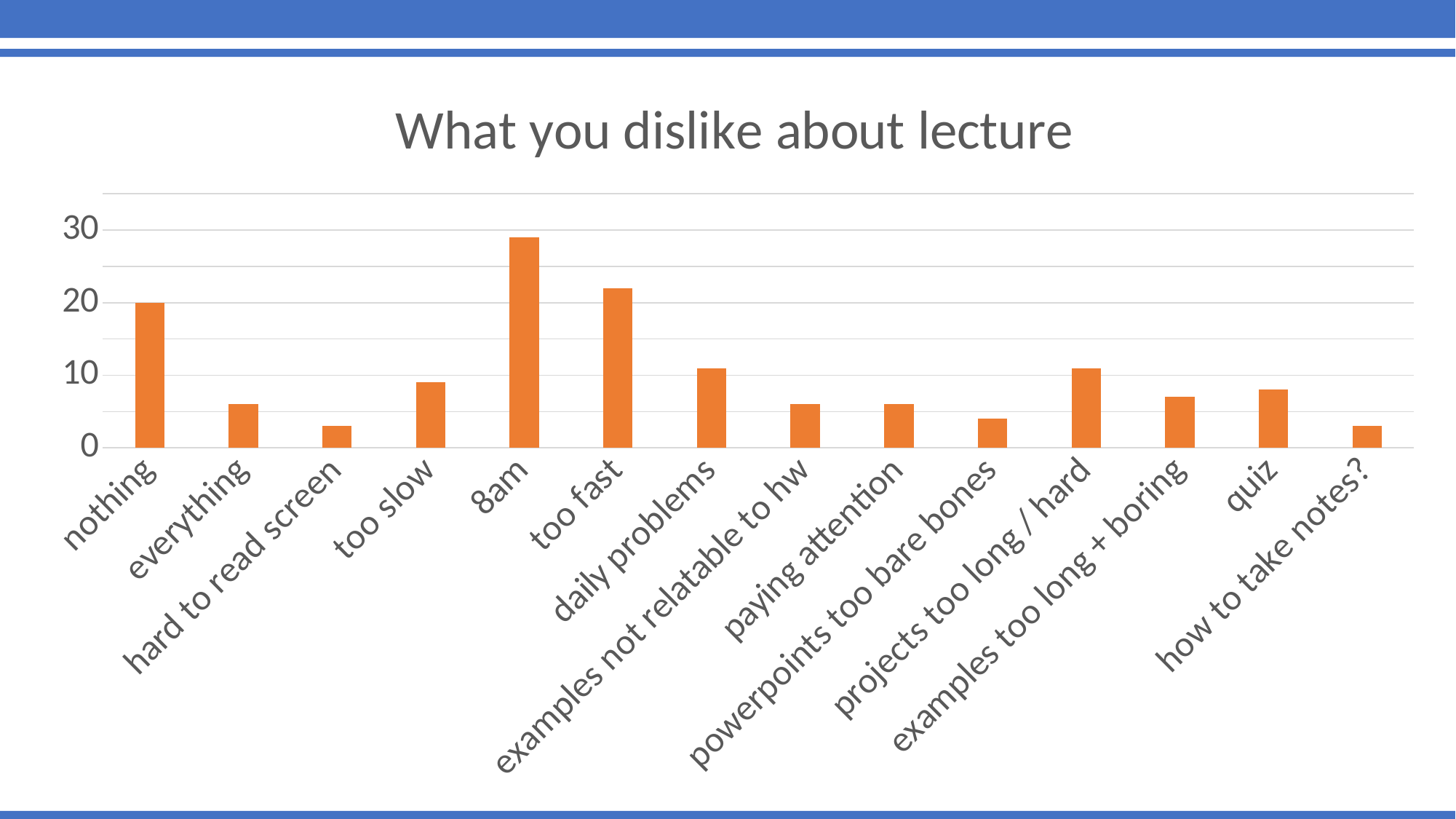
Is the value for "8am" greater or less than 20? greater Which category has the highest value? 8am What is the value for "nothing"? 20 Is the value for "everything" greater or less than 10? less Is the value for "powerpoints too bare bones" greater or less than 10? less Which has a larger value, "8am" or "too fast"? 8am What kind of chart is shown on the slide? bar chart How many categories are shown on the x axis of the chart? 14 What is the title of the chart? What you dislike about lecture Which has a larger value, "quiz" or "too fast"? too fast Which has a larger value, "nothing" or "everything"? nothing